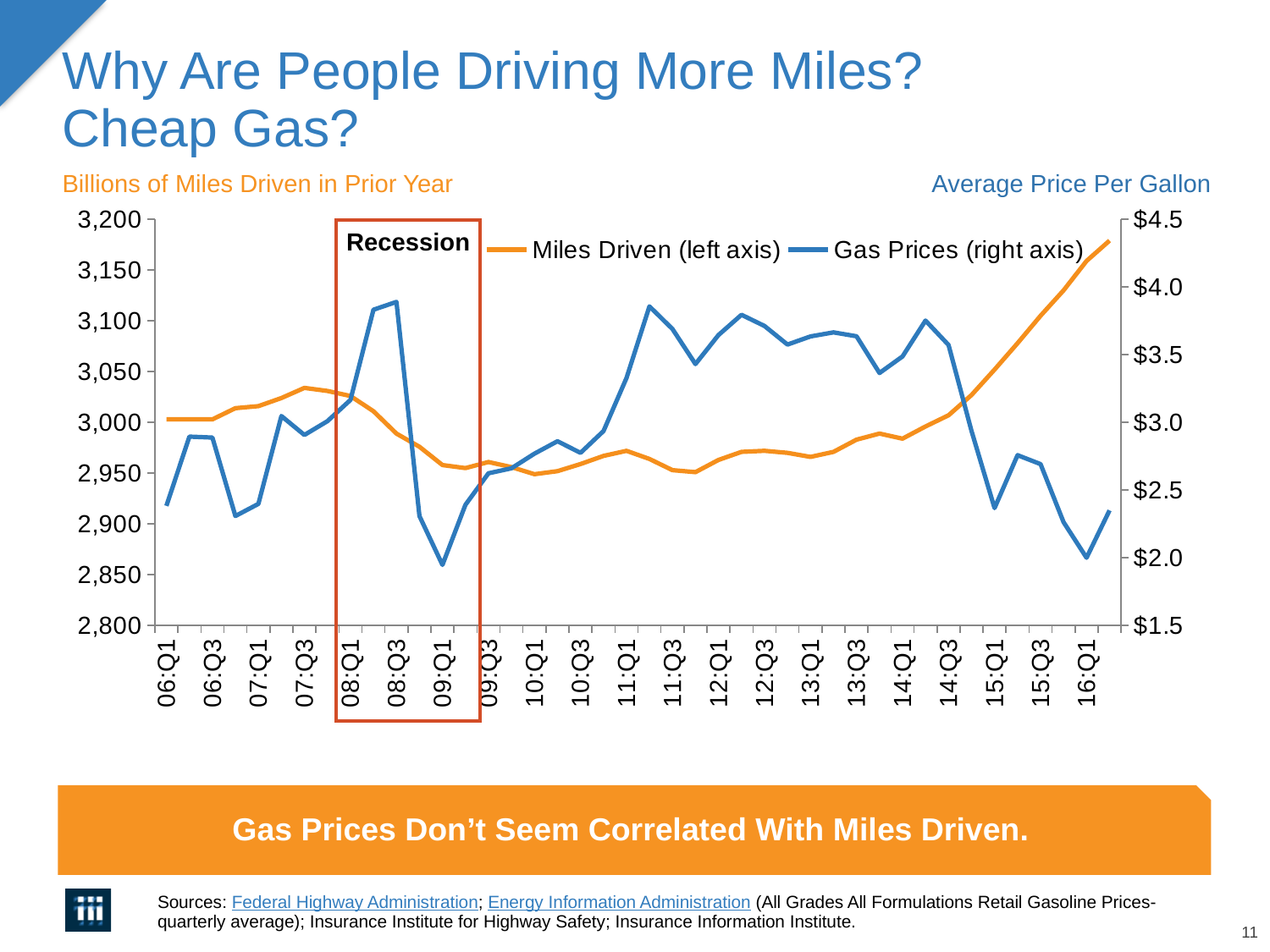
Is the Miles Driven value at 07:Q3 greater or less than 3,000? greater Is the Gas Prices value at 08:Q3 greater or less than $3.5? greater Is the Miles Driven value at 16:Q1 greater or less than 3,150? greater What label is shown inside the red box on the chart? Recession At which quarter does the Miles Driven series reach its highest value? 16:Q2 Which series is plotted against the right axis according to the legend? Gas Prices Does the Miles Driven series rise or fall from 14:Q1 to 16:Q1? Rise Does the Gas Prices series rise or fall from 14:Q1 to 15:Q1? Fall What kind of chart is shown on the slide? Line chart How many series does the chart's legend list? 2